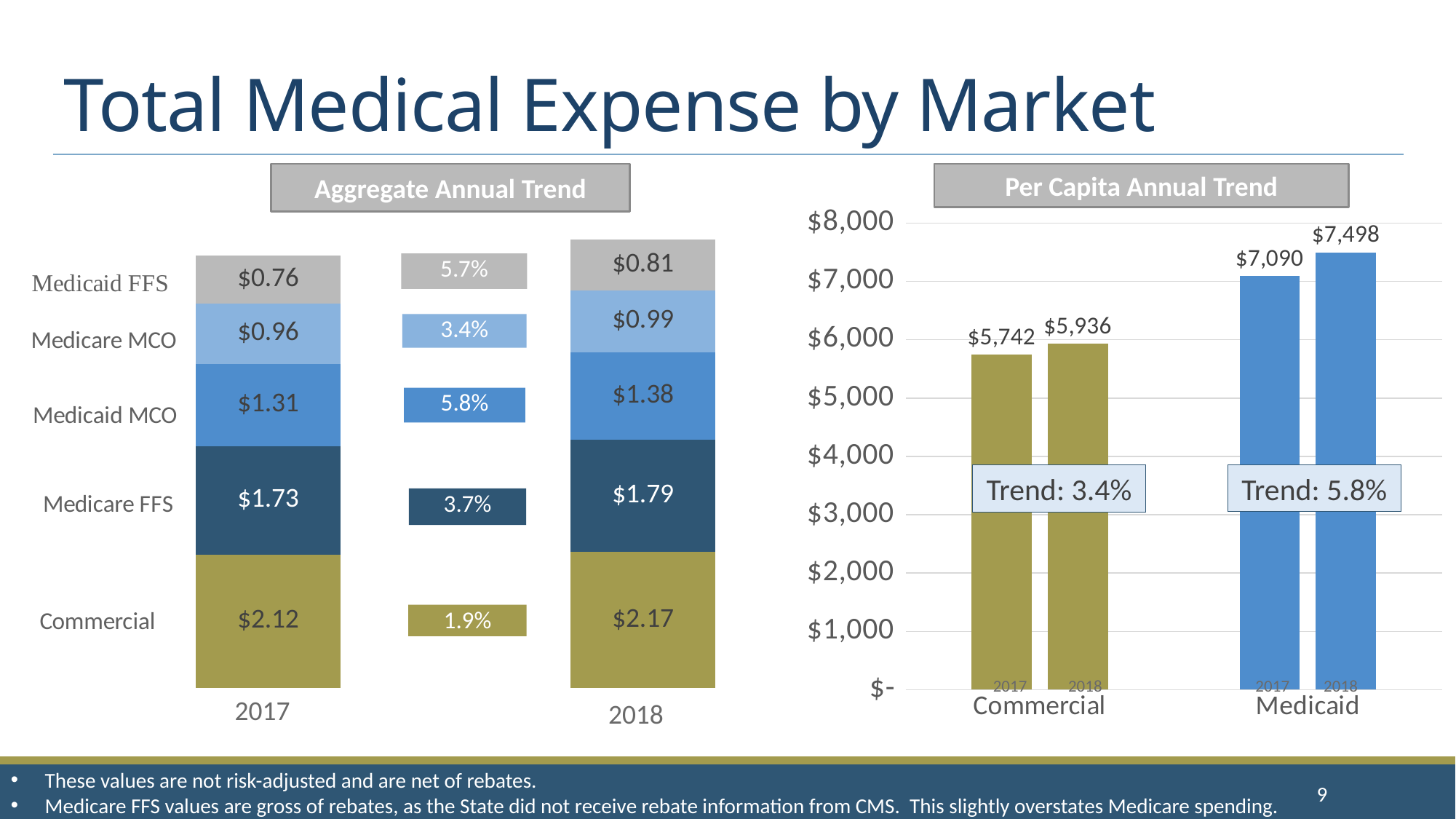
In the Per Capita Annual Trend chart, what is the Medicaid value for 2018? $7,498 In the Aggregate Annual Trend chart, what is the Medicaid FFS value for 2018? $0.81 In the Aggregate Annual Trend chart, what is the Medicare FFS value for 2018? $1.79 In the Per Capita Annual Trend chart, what is the difference between the Medicaid values for 2018 and 2017? $408 In the Aggregate Annual Trend chart, what is the total of the 2018 stacked bar? $7.14 In the Aggregate Annual Trend chart, which segment has the smallest value in 2017? Medicaid FFS In the Aggregate Annual Trend chart, what annual trend percentage is shown for Medicaid MCO? 5.8% In the Per Capita Annual Trend chart, what is the Commercial value for 2017? $5,742 What kind of chart is the Per Capita Annual Trend chart? Bar chart In the Aggregate Annual Trend chart, what is the Commercial value for 2017? $2.12 In the Per Capita Annual Trend chart, which is larger, Commercial 2018 or Medicaid 2017? Medicaid 2017 In the Aggregate Annual Trend chart, what is the difference between the Medicaid MCO values for 2018 and 2017? $0.07